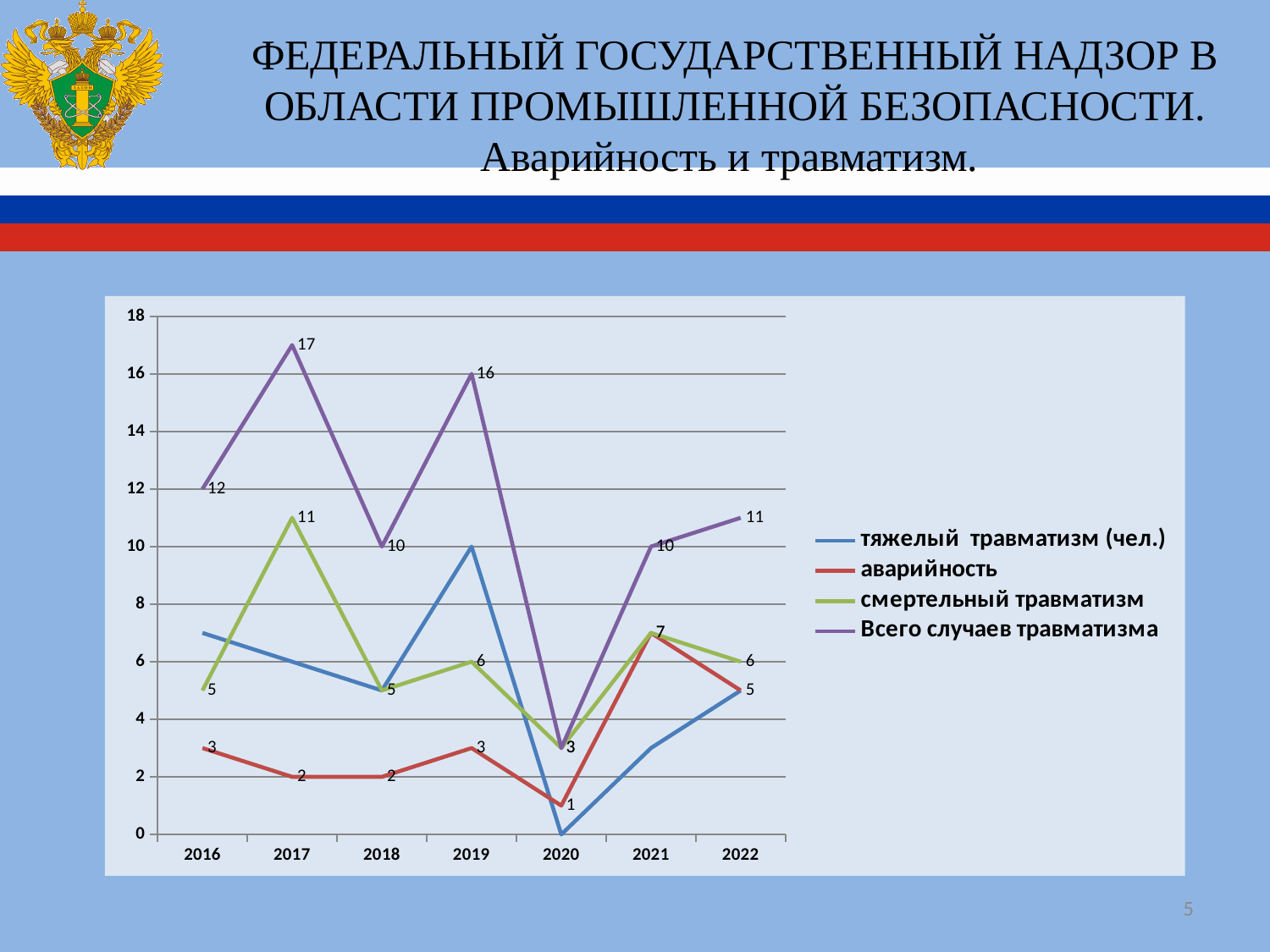
In which year is аварийность lowest? 2020 What is the difference between Всего случаев травматизма in 2019 and in 2020? 13 How many series does the legend list? 4 Which year has the larger value for смертельный травматизм, 2017 or 2022? 2017 In which year is Всего случаев травматизма highest? 2017 What is the value of смертельный травматизм in 2021? 7 Is the value for тяжелый травматизм (чел.) in 2021 greater or less than 4? less How many years are shown on the x axis? 7 Does Всего случаев травматизма rise or fall from 2020 to 2022? rise What kind of chart is shown on the slide? line chart What is the value of Всего случаев травматизма in 2017? 17 What is the value of аварийность in 2022? 5